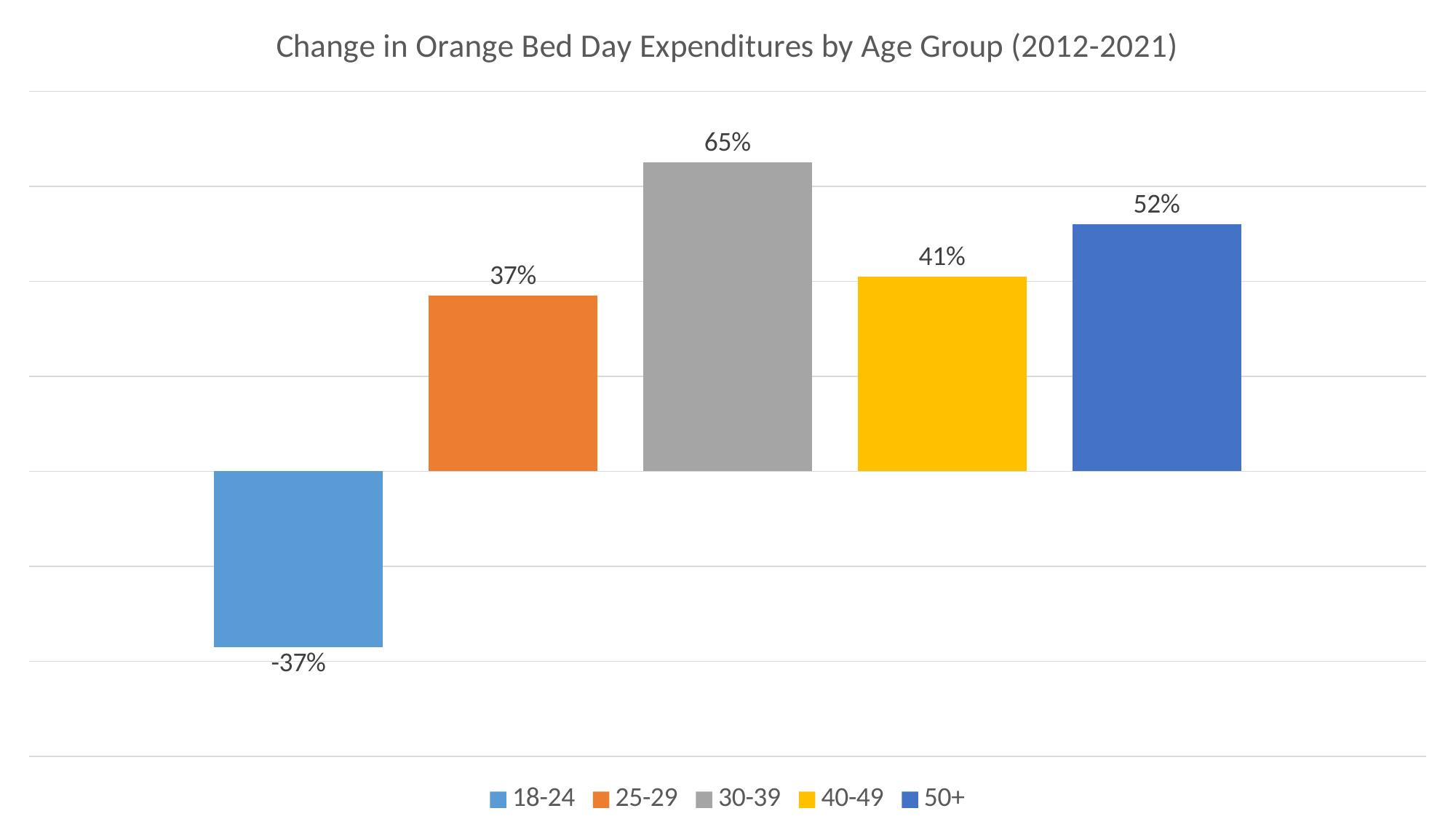
What is the change in Orange Bed Day expenditures for the 40-49 age group? 41% What is the change in Orange Bed Day expenditures for the 50+ age group? 52% How many age groups are shown in the chart? 5 What is the change in Orange Bed Day expenditures for the 30-39 age group? 65% What is the title of the chart? Change in Orange Bed Day Expenditures by Age Group (2012-2021) What type of chart is shown on the slide? Bar chart Which age group has a larger change in expenditures, 25-29 or 50+? 50+ What is the difference between the change for the 40-49 age group and the 25-29 age group? 4% Which age group has the highest change in Orange Bed Day expenditures? 30-39 What is the difference between the change for the 30-39 age group and the 50+ age group? 13% Which age group has the lowest change in Orange Bed Day expenditures? 18-24 What is the change in Orange Bed Day expenditures for the 18-24 age group? -37%